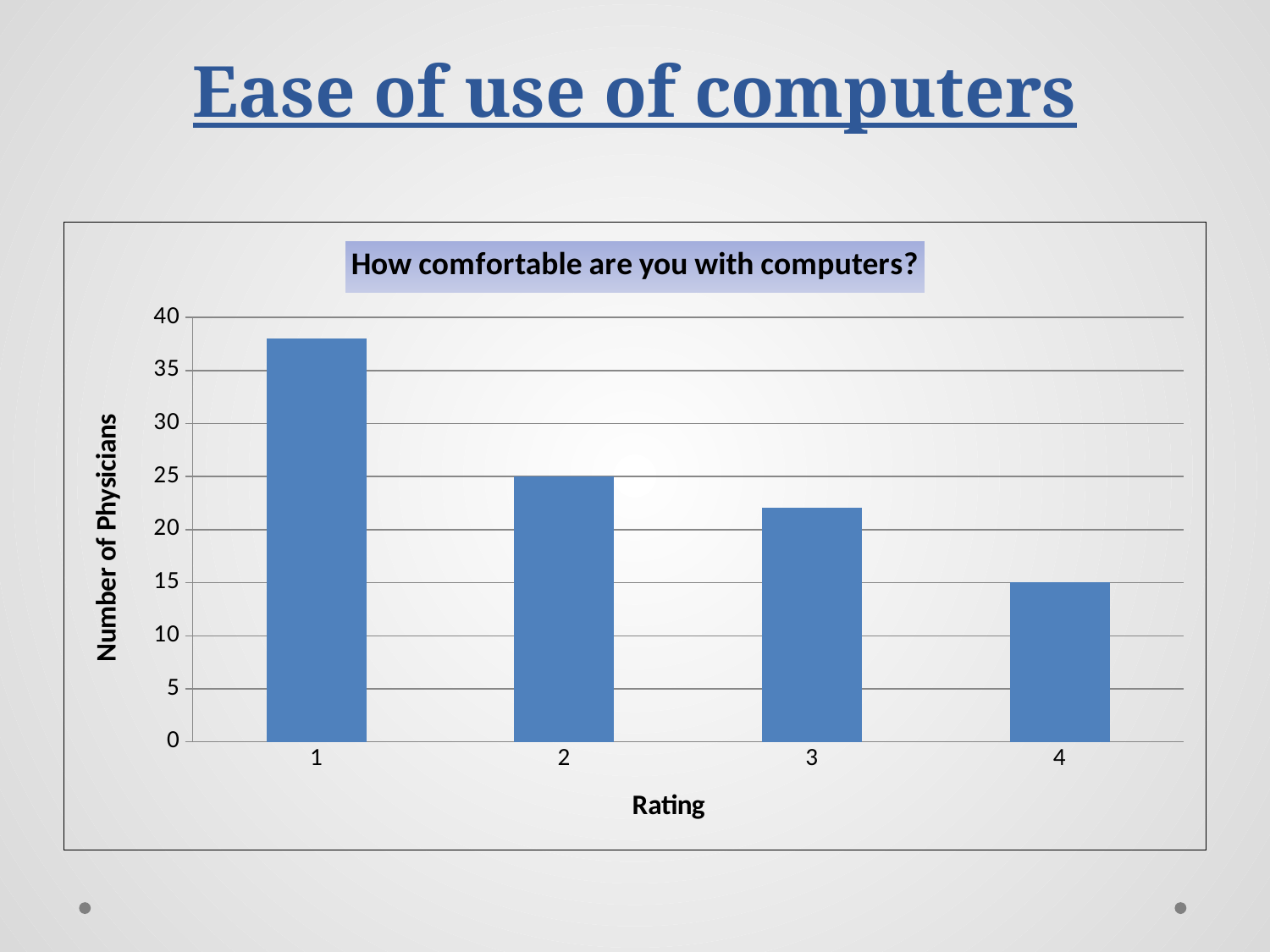
How many rating categories are shown on the x axis? 4 What is the label of the vertical axis? Number of Physicians What is the difference in number of physicians between rating 2 and rating 4? 10 Which rating has the lowest number of physicians? 4 What is the number of physicians for rating 4? 15 Is the number of physicians for rating 1 greater or less than 35? greater What type of chart is shown on the slide? bar chart What is the title of the chart? How comfortable are you with computers? Is the number of physicians for rating 3 greater or less than 20? greater Which rating has the highest number of physicians? 1 Which has more physicians, rating 2 or rating 3? rating 2 What is the number of physicians for rating 2? 25